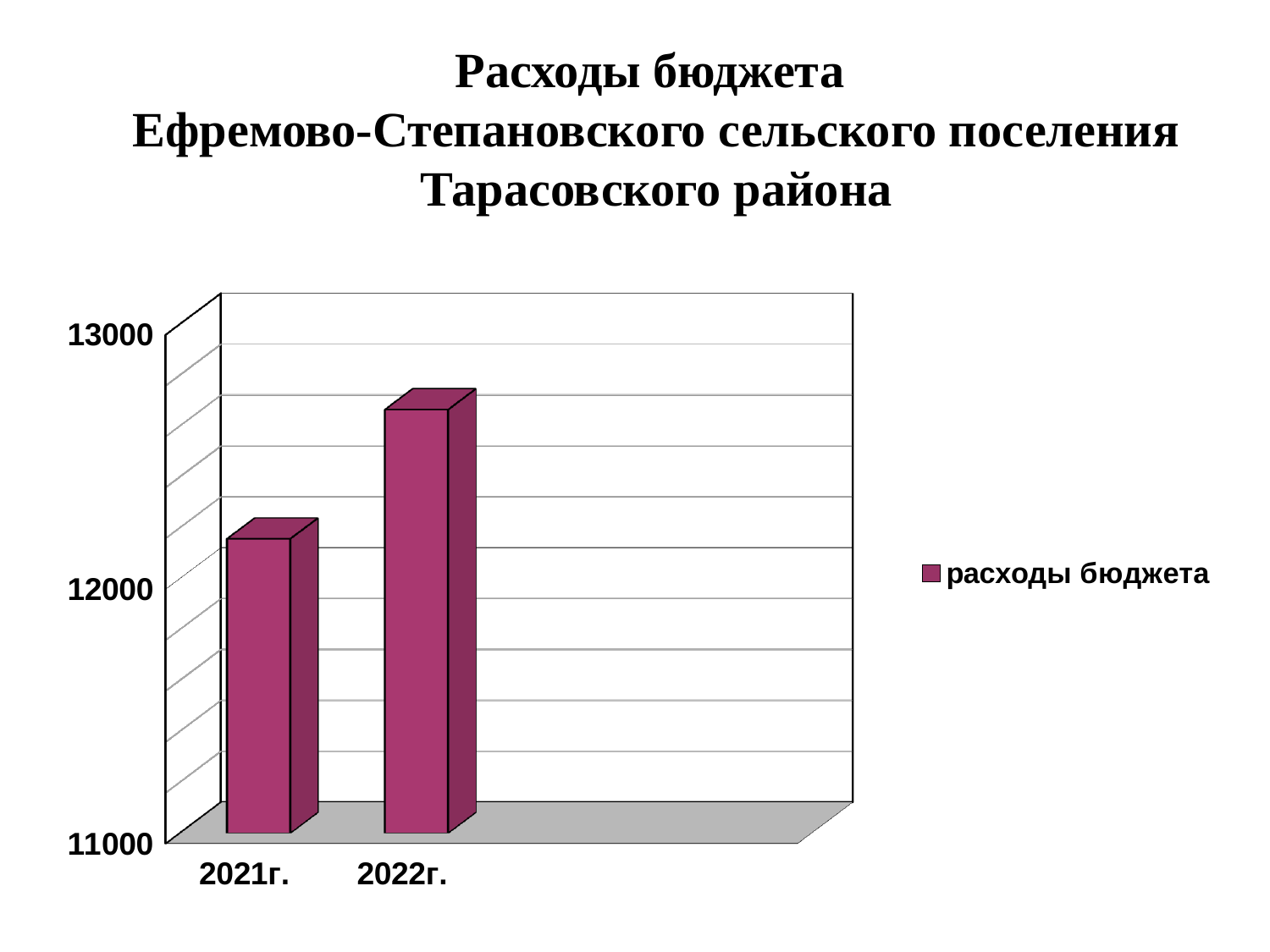
What is the lowest value shown on the vertical axis? 11000 What kind of chart is shown on the slide? bar chart Which year has the highest value for расходы бюджета? 2022г. Which year has the lowest value for расходы бюджета? 2021г. Which is larger, the value for 2021г. or the value for 2022г.? 2022г. What is the name of the series shown in the legend? расходы бюджета How many series does the legend list? 1 Is the value for 2022г. greater or less than 12000? greater Is the value for 2021г. greater or less than 12000? greater Is the value for 2022г. greater or less than 13000? less Do the values rise or fall from 2021г. to 2022г.? rise How many categories are shown on the x axis? 2